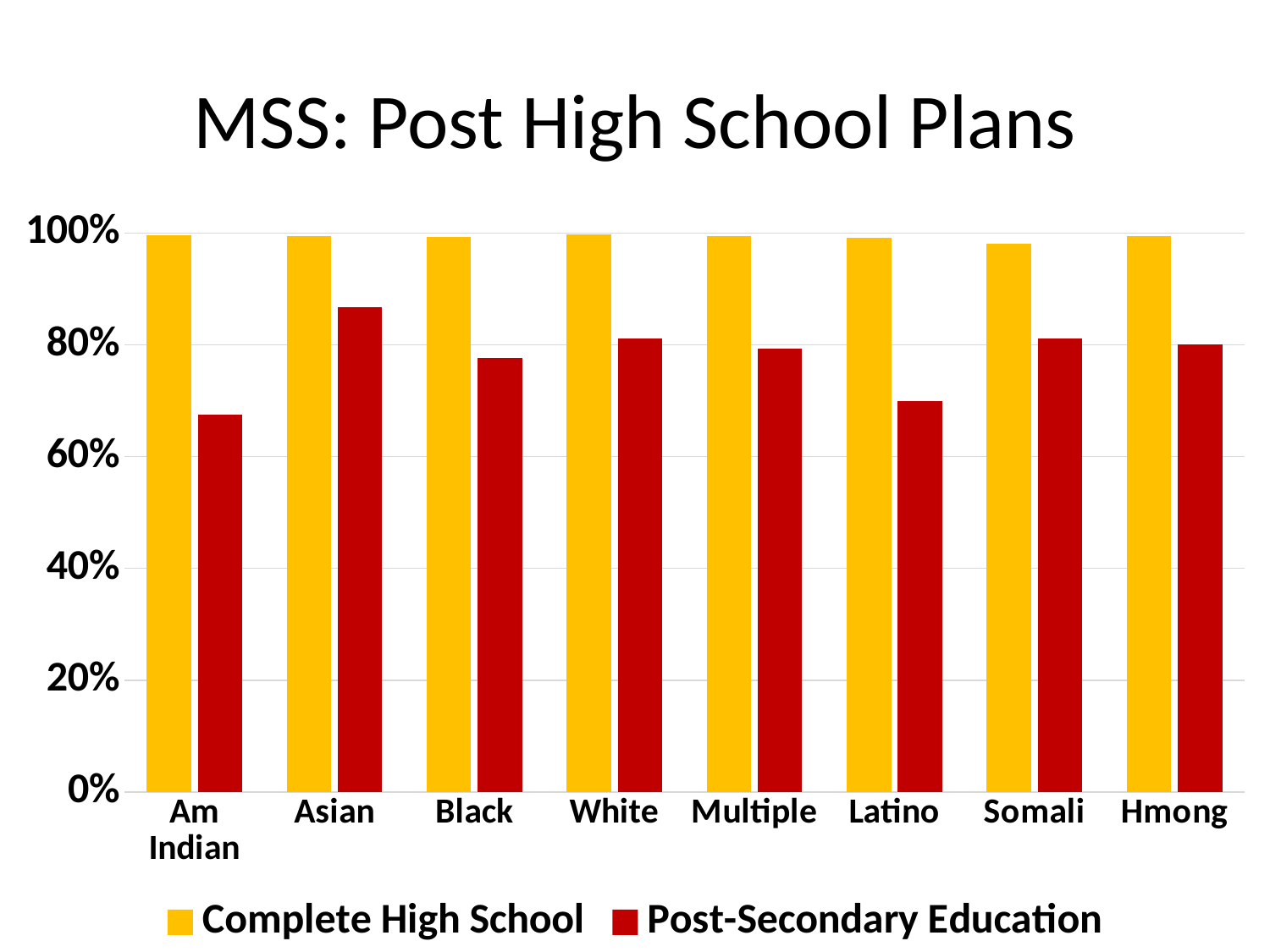
Which colour represents the Post-Secondary Education series? red What is the title of the chart? MSS: Post High School Plans Is the Post-Secondary Education value for Asian greater or less than 80%? greater How many categories are shown on the x axis? 8 Which is larger, the Post-Secondary Education value for Asian or for Latino? Asian Is the Post-Secondary Education value for Latino greater or less than 80%? less Is the Post-Secondary Education value for Am Indian greater or less than 80%? less Which category has the lowest value for Post-Secondary Education? Am Indian Which category has the highest value for Post-Secondary Education? Asian How many series does the legend list? 2 What kind of chart is shown on the slide? bar chart